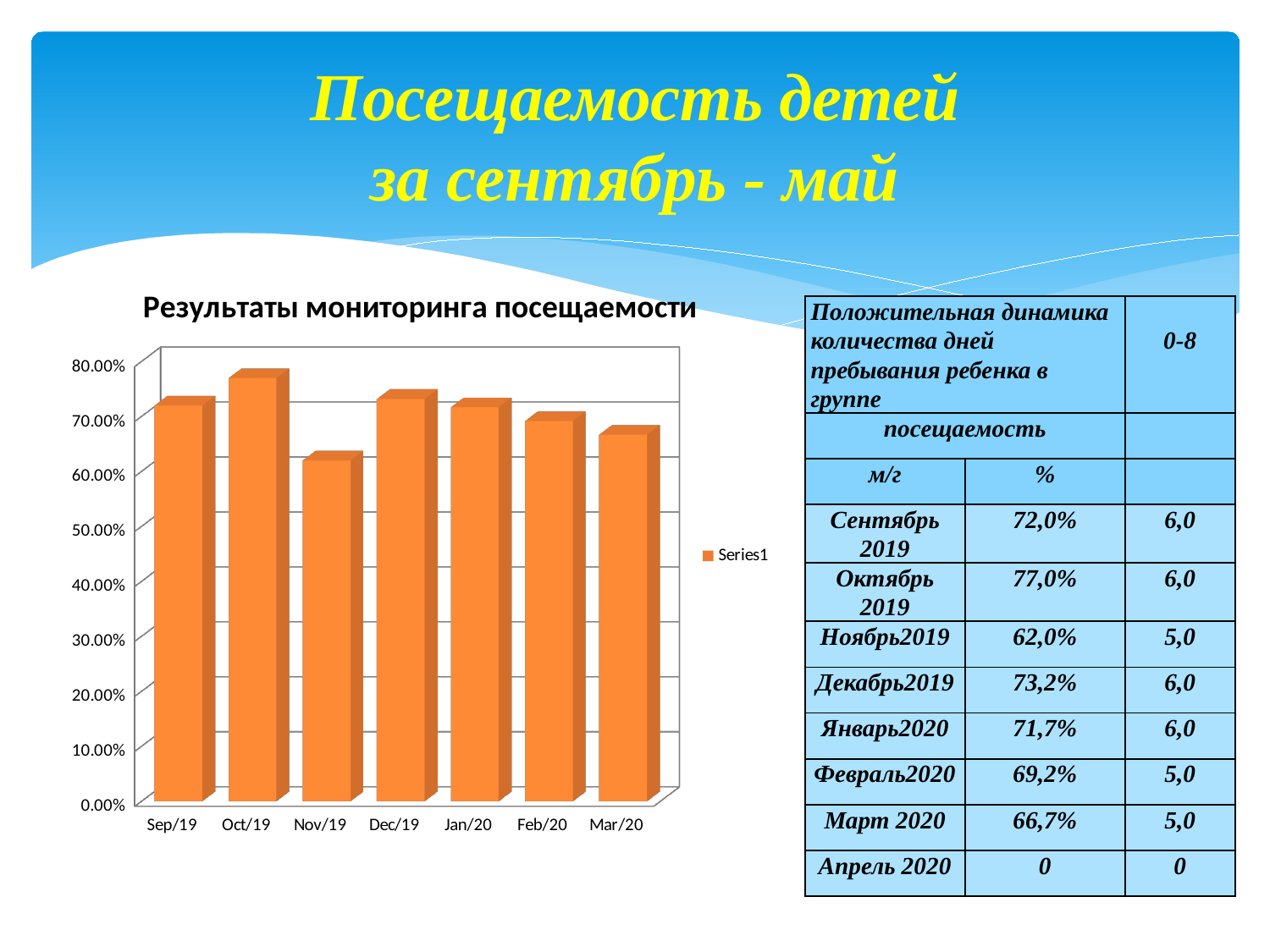
Do the values rise or fall from Dec/19 to Mar/20? fall Which month has the lowest bar in the chart? Nov/19 Is the value for Mar/20 greater or less than 70.00%? less How many months are plotted on the x axis of the chart? 7 What kind of chart is shown on the slide? bar chart Which month has the highest bar in the chart? Oct/19 Is the value for Oct/19 greater or less than 70.00%? greater Which is larger, the value for Oct/19 or the value for Mar/20? Oct/19 What is the title of the chart? Результаты мониторинга посещаемости What is the name of the series shown in the chart legend? Series1 How many series does the chart legend list? 1 Is the value for Nov/19 greater or less than 70.00%? less